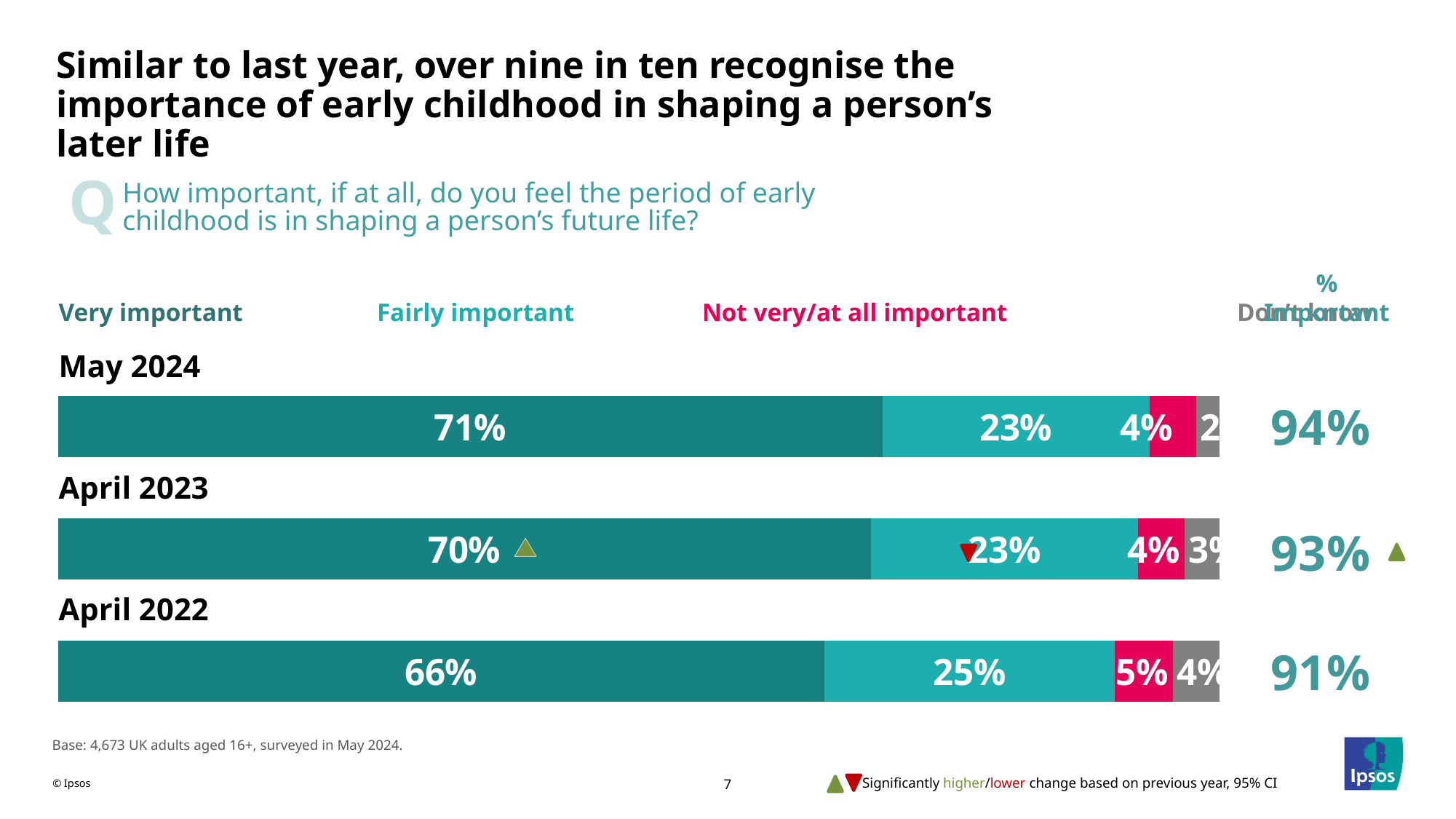
What is the "% Important" figure shown for April 2023? 93% What is the "Not very/at all important" value for April 2022? 5% What colour represents the "Not very/at all important" segment? Pink/red What percentage of respondents said early childhood is "Very important" in May 2024? 71% How many survey waves are shown in the chart? 3 What percentage said "Fairly important" in April 2022? 25% By how many percentage points did the "Very important" share change between April 2022 and May 2024? 5 percentage points How does the "% Important" figure change from April 2022 to May 2024? It rises Which survey wave has the highest "Very important" percentage? May 2024 Is the "Fairly important" share larger in April 2022 or in May 2024? April 2022 What type of chart is used on this slide? Stacked bar chart Which survey wave has the lowest "% Important" figure? April 2022